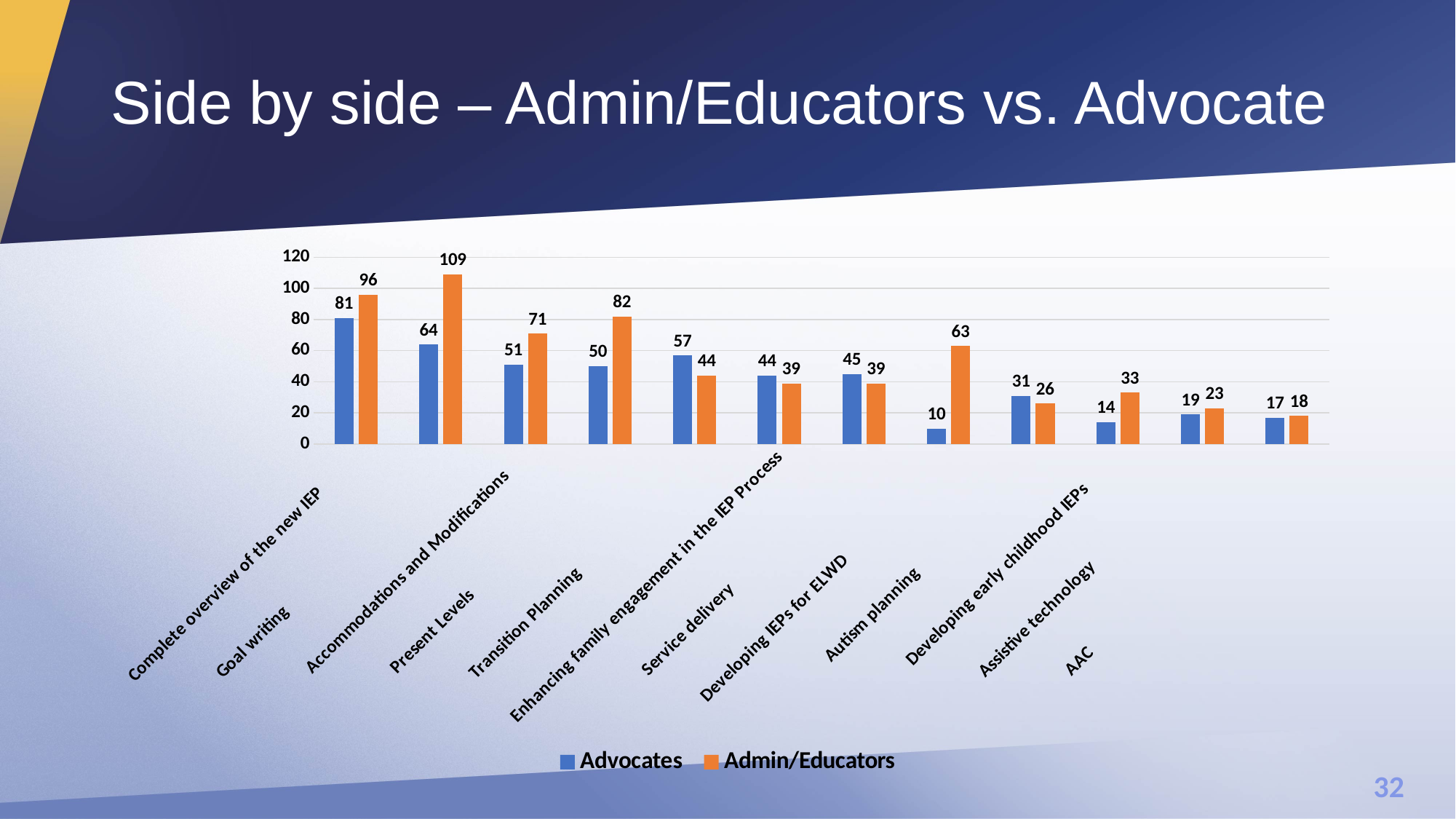
How many categories are shown on the x axis? 12 What is the Admin/Educators value for Goal writing? 109 What kind of chart is shown on the slide? Bar chart What is the Advocates value for Developing IEPs for ELWD? 10 Which category has the lowest Advocates value? Developing IEPs for ELWD How many series does the legend list? 2 What is the Admin/Educators value for Developing early childhood IEPs? 33 Which colour represents the Admin/Educators series? Orange For Transition Planning, which is larger: the Advocates value or the Admin/Educators value? Advocates What is the difference between the Admin/Educators and Advocates values for Present Levels? 32 Which category has the highest Admin/Educators value? Goal writing What is the Advocates value for Complete overview of the new IEP? 81